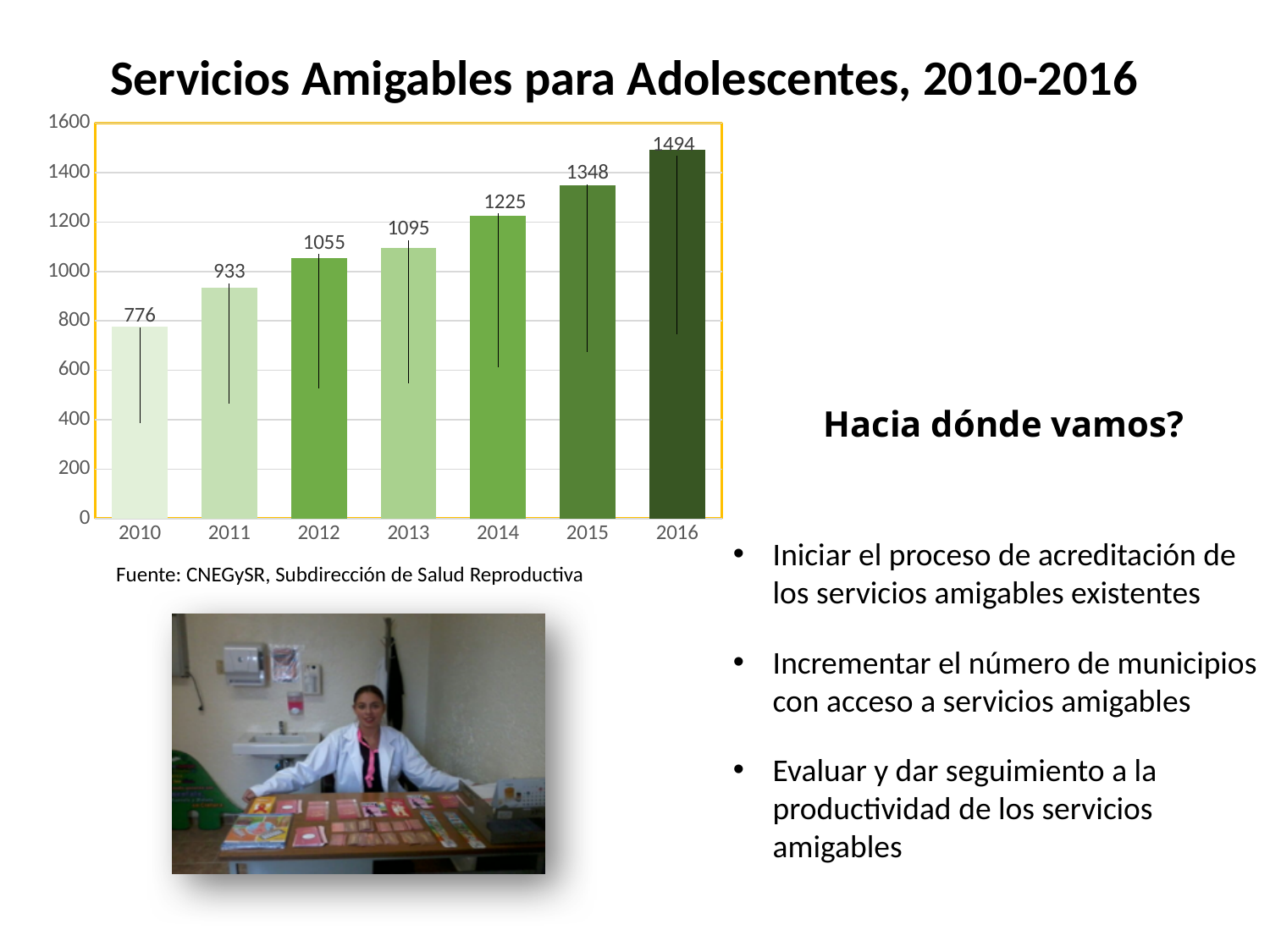
Do the values rise or fall from 2010 to 2016? rise How many years are shown on the x axis? 7 What is the value for 2013? 1095 Which is larger, the value for 2014 or the value for 2015? 2015 What kind of chart is shown on the slide? bar chart Is the value for 2013 greater or less than 1000? greater What is the value for 2016? 1494 Which year has the lowest value? 2010 What is the difference between the values for 2012 and 2011? 122 What is the value for 2010? 776 Which year has the highest value? 2016 What is the difference between the values for 2016 and 2010? 718